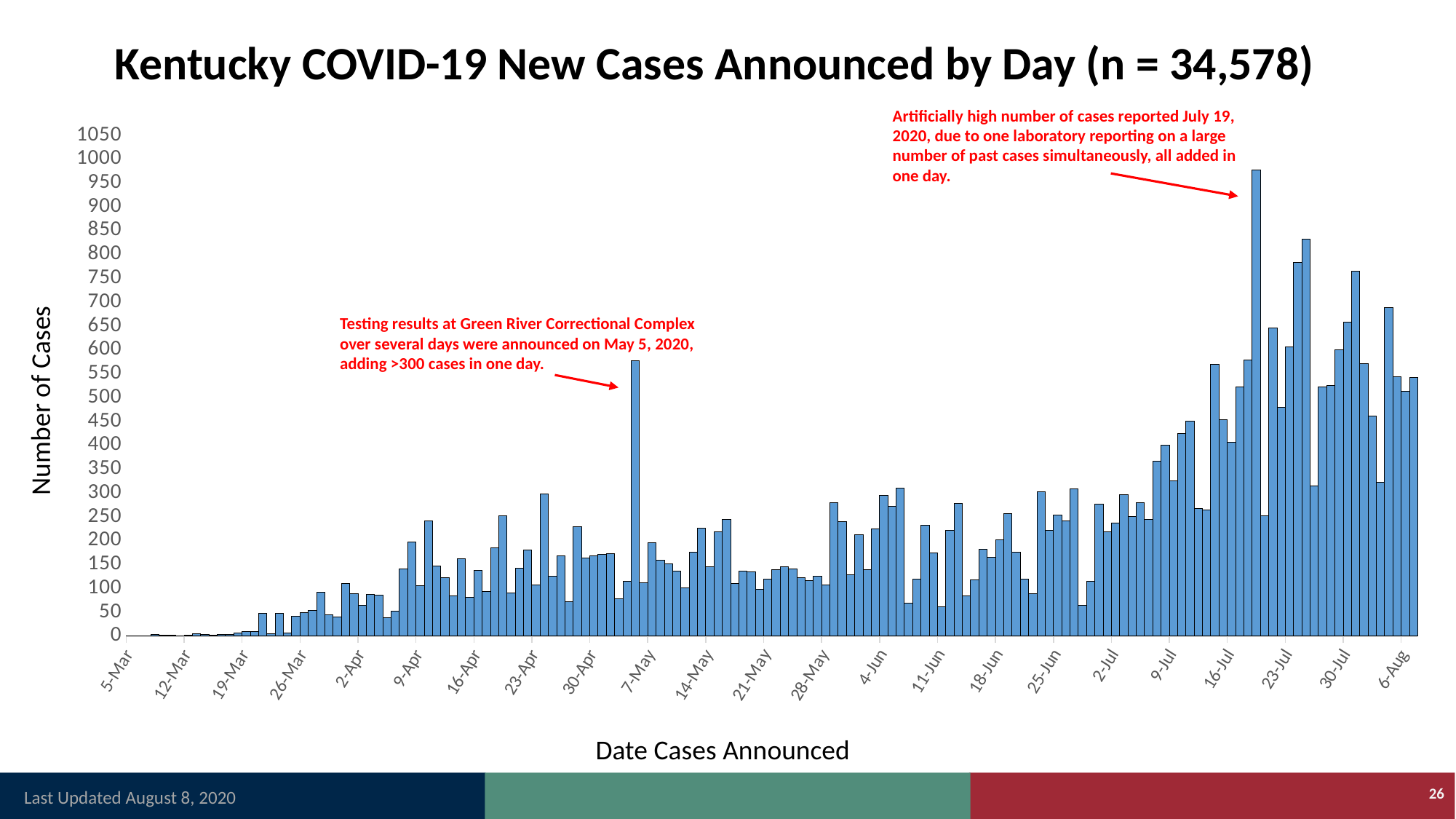
Is the value for the July 19, 2020 bar greater or less than 900? greater What is the label on the y axis of the chart? Number of Cases Is the value for 5-Mar greater or less than 50? less Is the value for 6-Aug greater or less than 400? greater What is the title of the chart? Kentucky COVID-19 New Cases Announced by Day (n = 34,578) Which date has the highest bar in the chart? July 19, 2020 What kind of chart is shown on the slide? bar chart Which bar is taller, the July 19, 2020 bar or the May 5, 2020 bar? July 19, 2020 Overall, do the daily new case counts rise or fall from March to August along the x axis? rise Which bar is taller, the May 5, 2020 spike bar or the 30-Apr bar? May 5, 2020